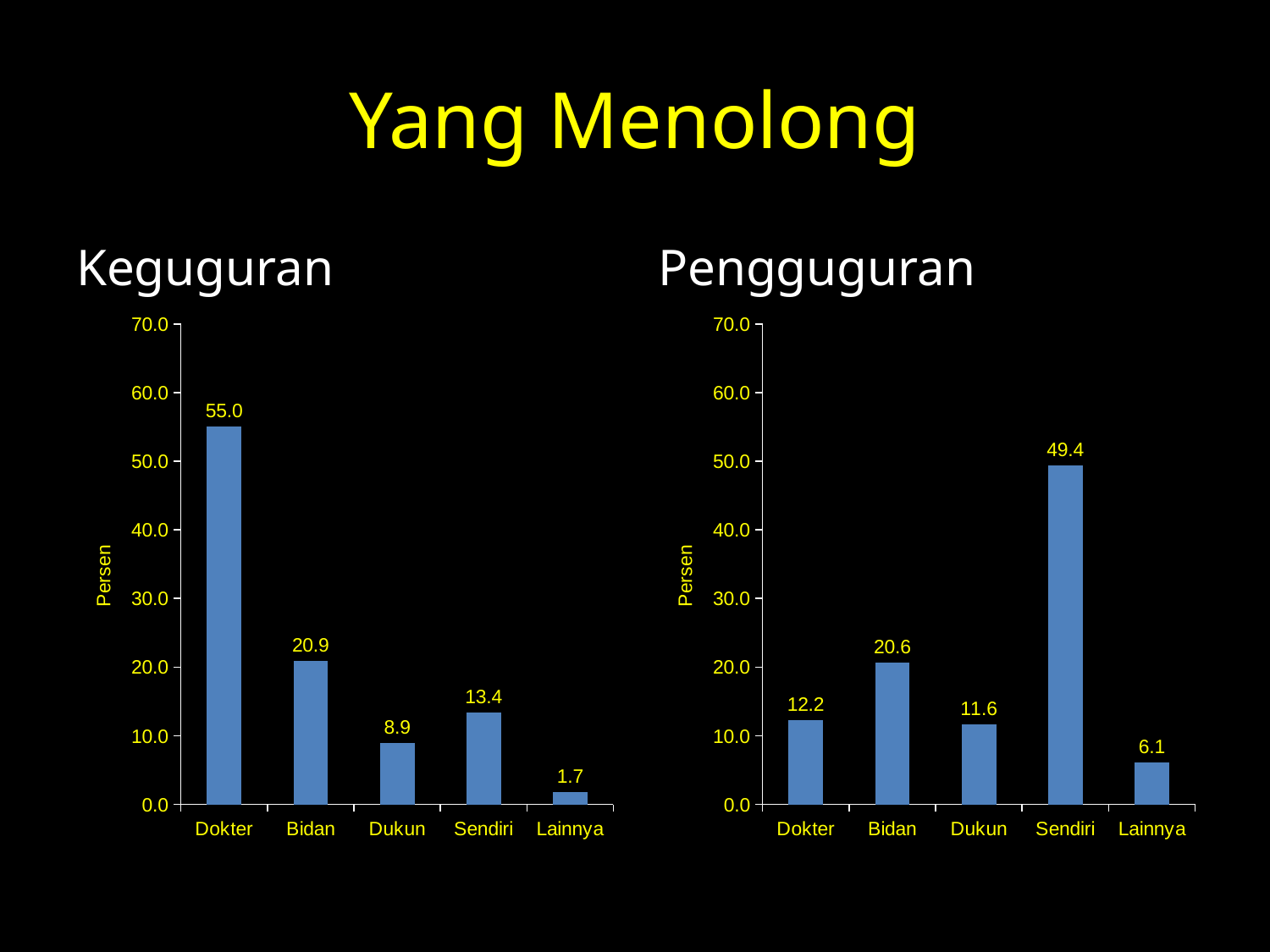
In the Keguguran chart, is the value for Sendiri greater or less than 10.0? greater How many categories are shown on the x axis of the Pengguguran chart? 5 What kind of chart is the Keguguran chart? bar chart In the Keguguran chart, which category has the lowest value? Lainnya In the Pengguguran chart, what is the value for Sendiri? 49.4 What is the y-axis label of the Pengguguran chart? Persen In the Keguguran chart, what is the difference between the values for Dokter and Bidan? 34.1 In the Keguguran chart, what is the value for Dokter? 55.0 In the Pengguguran chart, which is larger, the value for Dokter or the value for Dukun? Dokter In the Pengguguran chart, what is the difference between the values for Bidan and Lainnya? 14.5 In the Keguguran chart, what is the value for Dukun? 8.9 In the Pengguguran chart, which category has the highest value? Sendiri